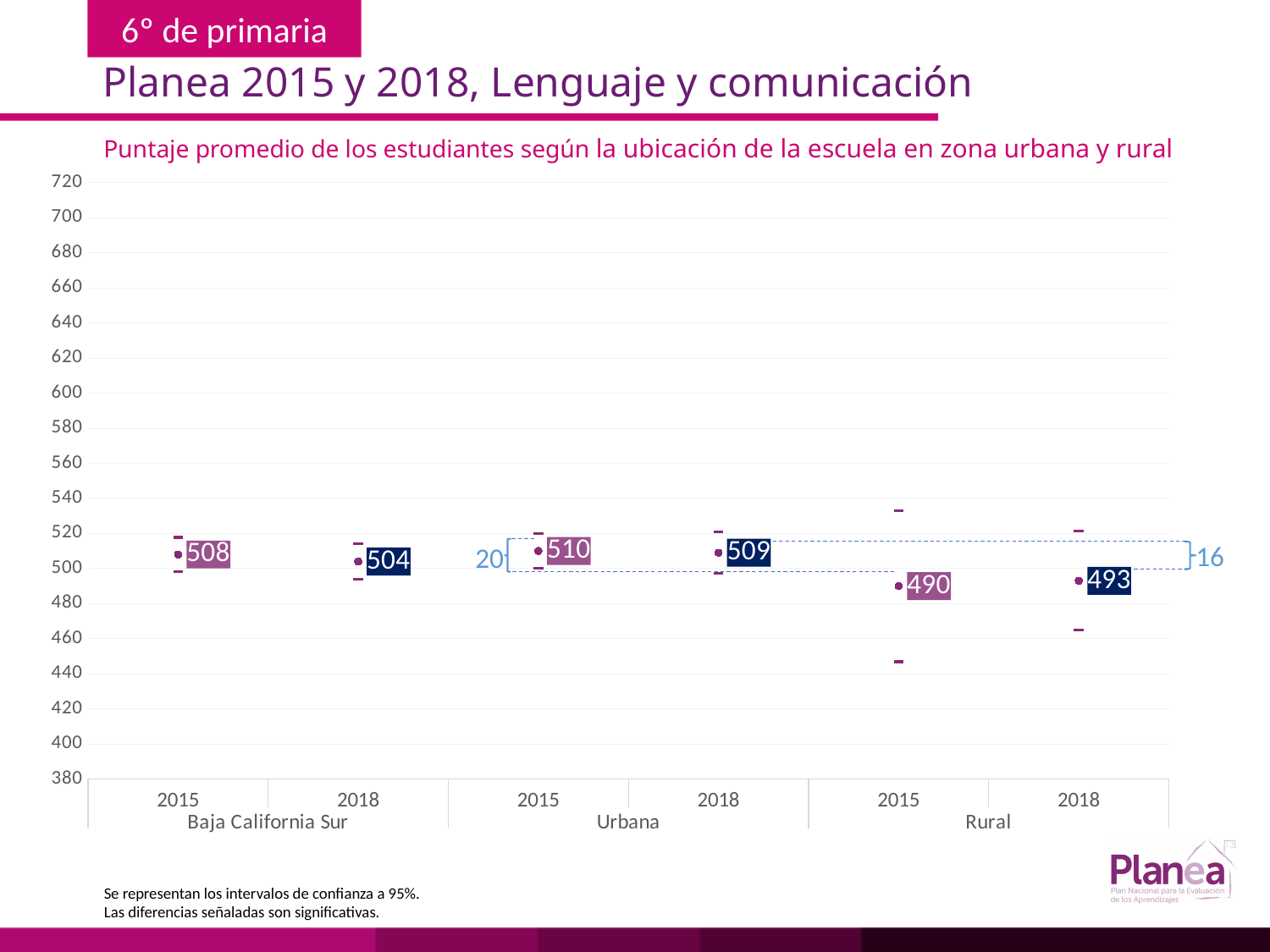
Did the average score for Baja California Sur rise or fall from 2015 to 2018? fall What is the average score for Rural schools in 2018? 493 What is the average score for Urbana schools in 2015? 510 What is the average score for Baja California Sur in 2018? 504 What is the difference between the Urbana and Rural average scores in 2018? 16 Which group and year has the lowest average score on the chart? Rural 2015 Which is larger, the Rural score in 2015 or the Rural score in 2018? Rural 2018 What is the difference between the Urbana and Rural average scores in 2015? 20 What is the average score for Baja California Sur in 2015? 508 How many data points are plotted on the chart? 6 Which group and year has the highest average score on the chart? Urbana 2015 What is the subtitle of the chart? Puntaje promedio de los estudiantes según la ubicación de la escuela en zona urbana y rural